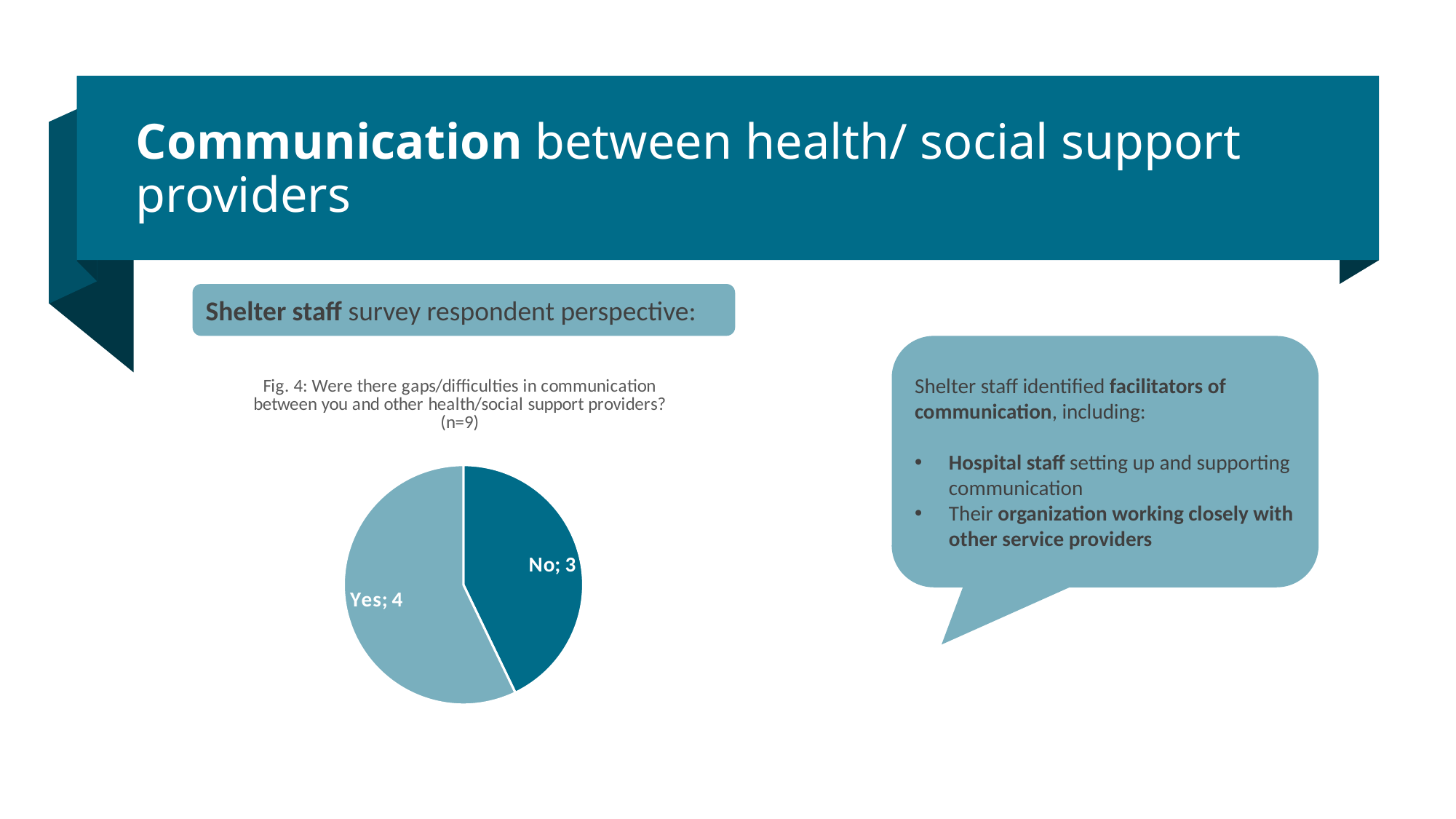
What is the difference between the number of Yes and No responses in the pie chart? 1 Which category has the largest slice in the pie chart? Yes What is the combined number of responses shown in the pie chart's data labels? 7 What type of chart is shown on the slide? Pie chart How many respondents answered "No" in Fig. 4? 3 What sample size (n) is stated in the chart title? n=9 Which category has the smallest slice in the pie chart? No What is the figure number of the pie chart? Fig. 4 How many slices does the pie chart have? 2 Which response has the larger slice in the pie chart, Yes or No? Yes How many respondents answered "Yes" in Fig. 4? 4